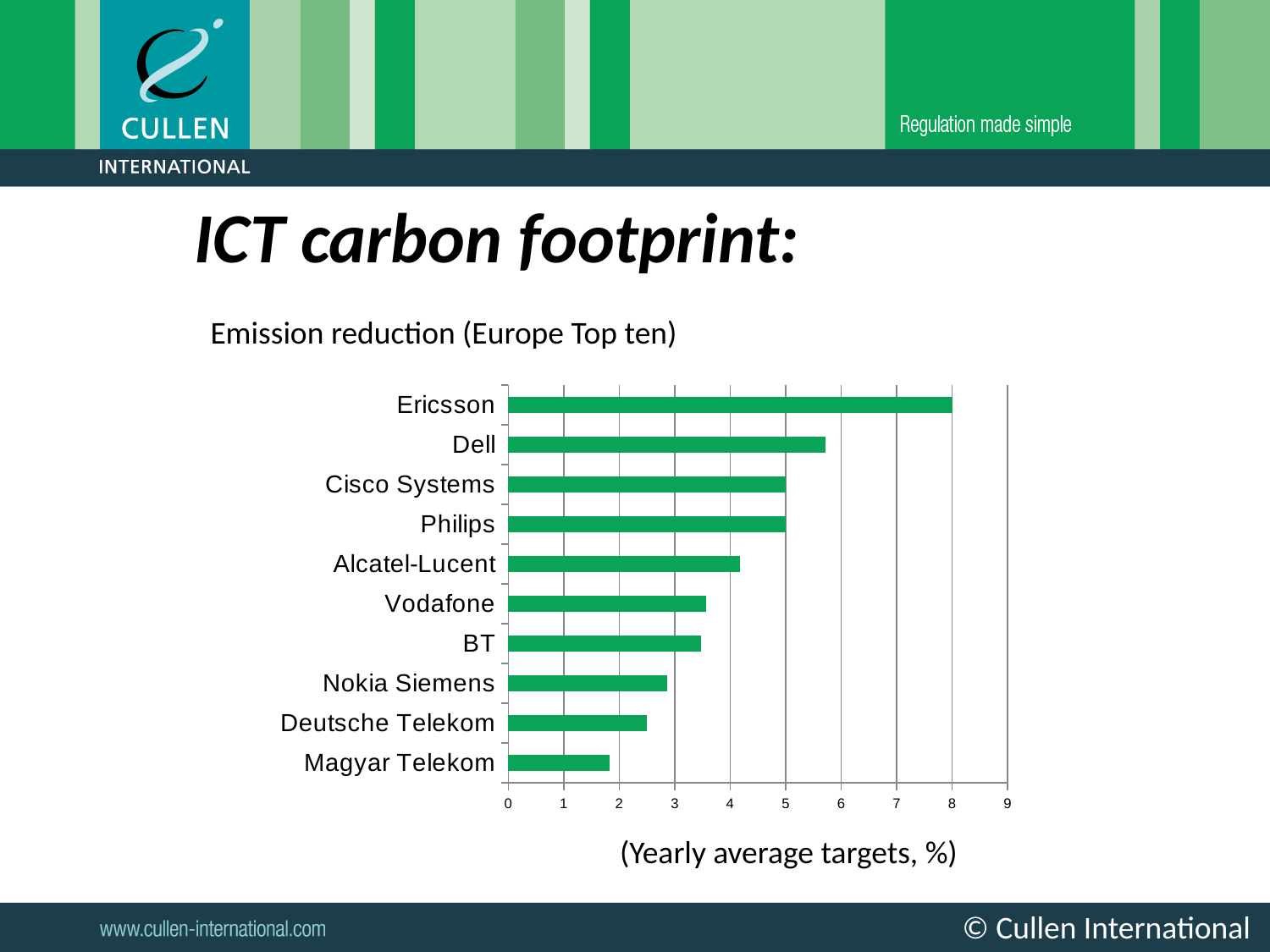
What unit is given for the values on the chart's axis? Yearly average targets, % Is the value for Dell greater or less than 5? greater How many companies are shown in the chart? 10 What is the yearly average target for Cisco Systems? 5 Which company has the highest yearly average emission reduction target? Ericsson Which company has the lowest yearly average emission reduction target? Magyar Telekom Which has a larger value, Dell or Alcatel-Lucent? Dell What kind of chart is shown on the slide? bar chart What is the title of the chart? Emission reduction (Europe Top ten) Is the value for Deutsche Telekom greater or less than 3? less Is the value for Magyar Telekom greater or less than 2? less What is the yearly average target for Ericsson? 8